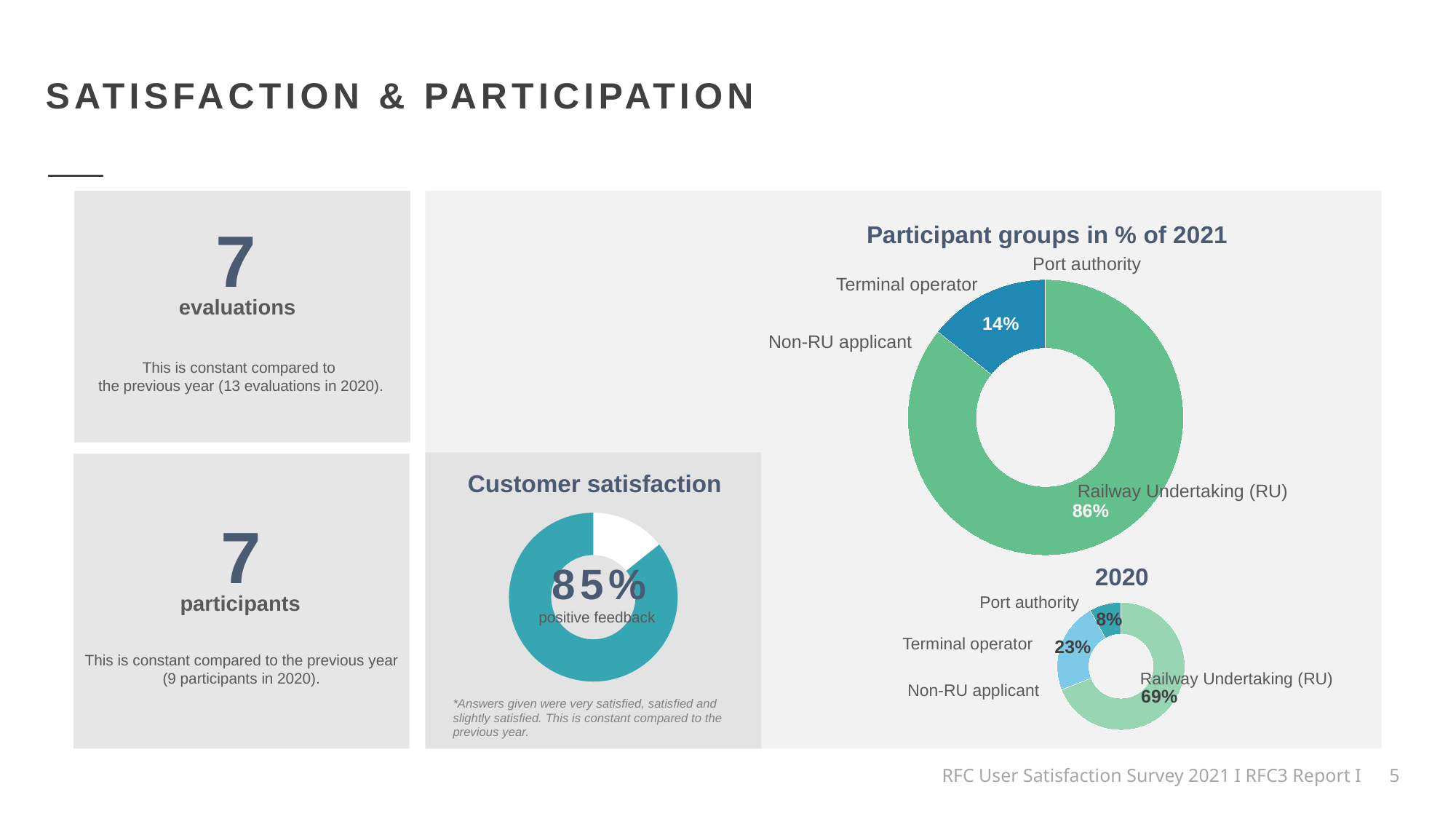
In the Participant groups in % of 2021 chart, what share is Terminal operator? 14% In the 2020 chart, what share is Port authority? 8% In the Customer satisfaction chart, what percentage of feedback was positive? 85% In the 2020 chart, what share is Railway Undertaking (RU)? 69% In the Participant groups in % of 2021 chart, which group has the largest share? Railway Undertaking (RU) In the 2020 chart, what share is Terminal operator? 23% What kind of chart is the Participant groups in % of 2021 chart? Donut (pie) chart In the Participant groups in % of 2021 chart, what is the difference between the Railway Undertaking (RU) share and the Terminal operator share? 72% By how many percentage points did the Railway Undertaking (RU) share change from the 2020 chart to the Participant groups in % of 2021 chart? 17% In the Participant groups in % of 2021 chart, what share is Railway Undertaking (RU)? 86% In the 2020 chart, which labelled group has the smallest share? Port authority In the 2020 chart, which is larger: Terminal operator or Port authority? Terminal operator